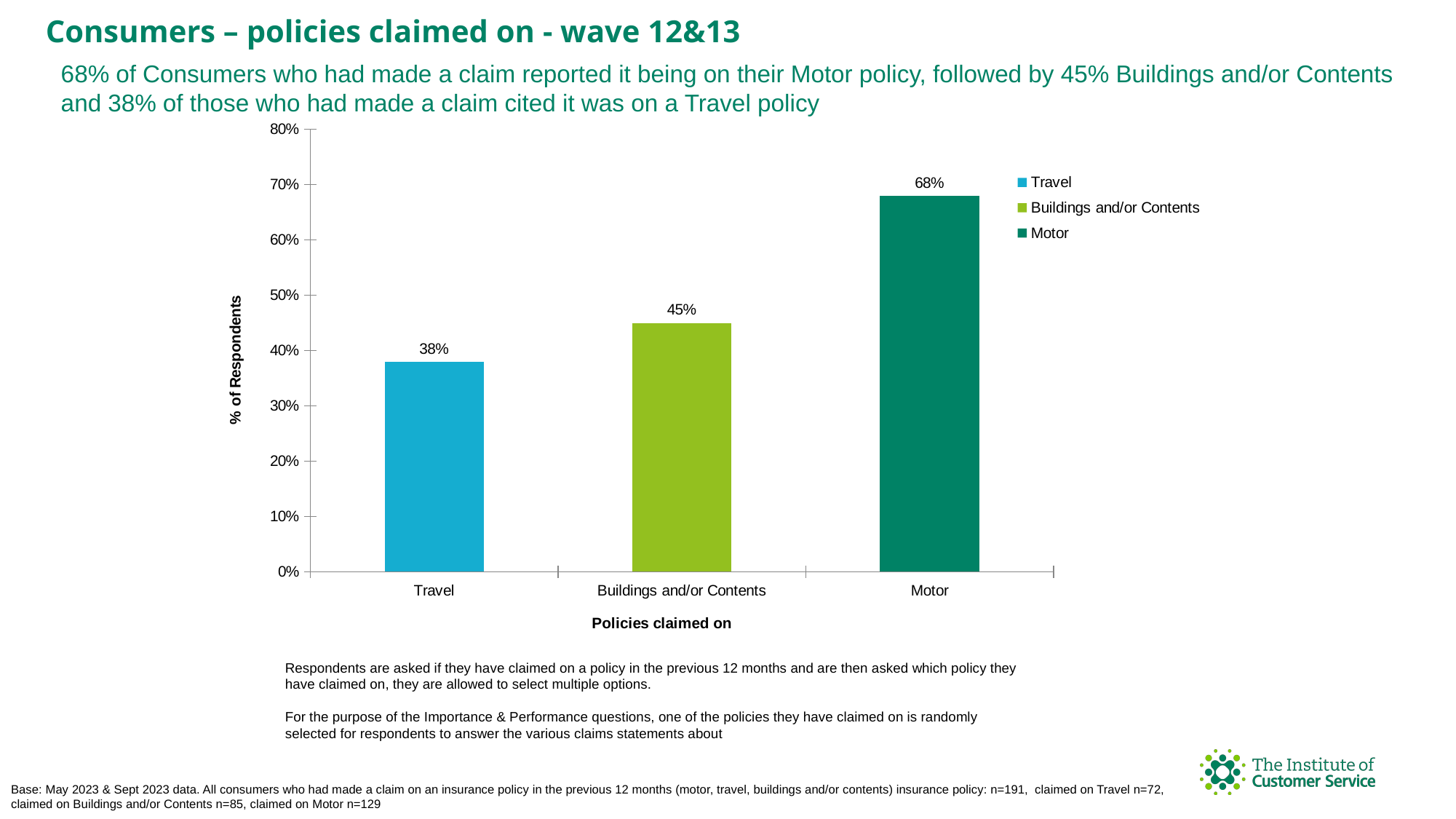
Is the value for Motor greater or less than 60%? greater Which policy type has the lowest percentage of respondents? Travel Which is larger, the value for Buildings and/or Contents or the value for Travel? Buildings and/or Contents What is the label of the y axis? % of Respondents How many policy categories are shown on the x axis? 3 What kind of chart is shown on the slide? Bar chart What is the difference in percentage points between Motor and Travel? 30 What percentage of respondents claimed on a Travel policy? 38% What is the difference in percentage points between Buildings and/or Contents and Travel? 7 Which policy type has the highest percentage of respondents? Motor What percentage of respondents claimed on a Motor policy? 68% What is the value shown for Buildings and/or Contents? 45%